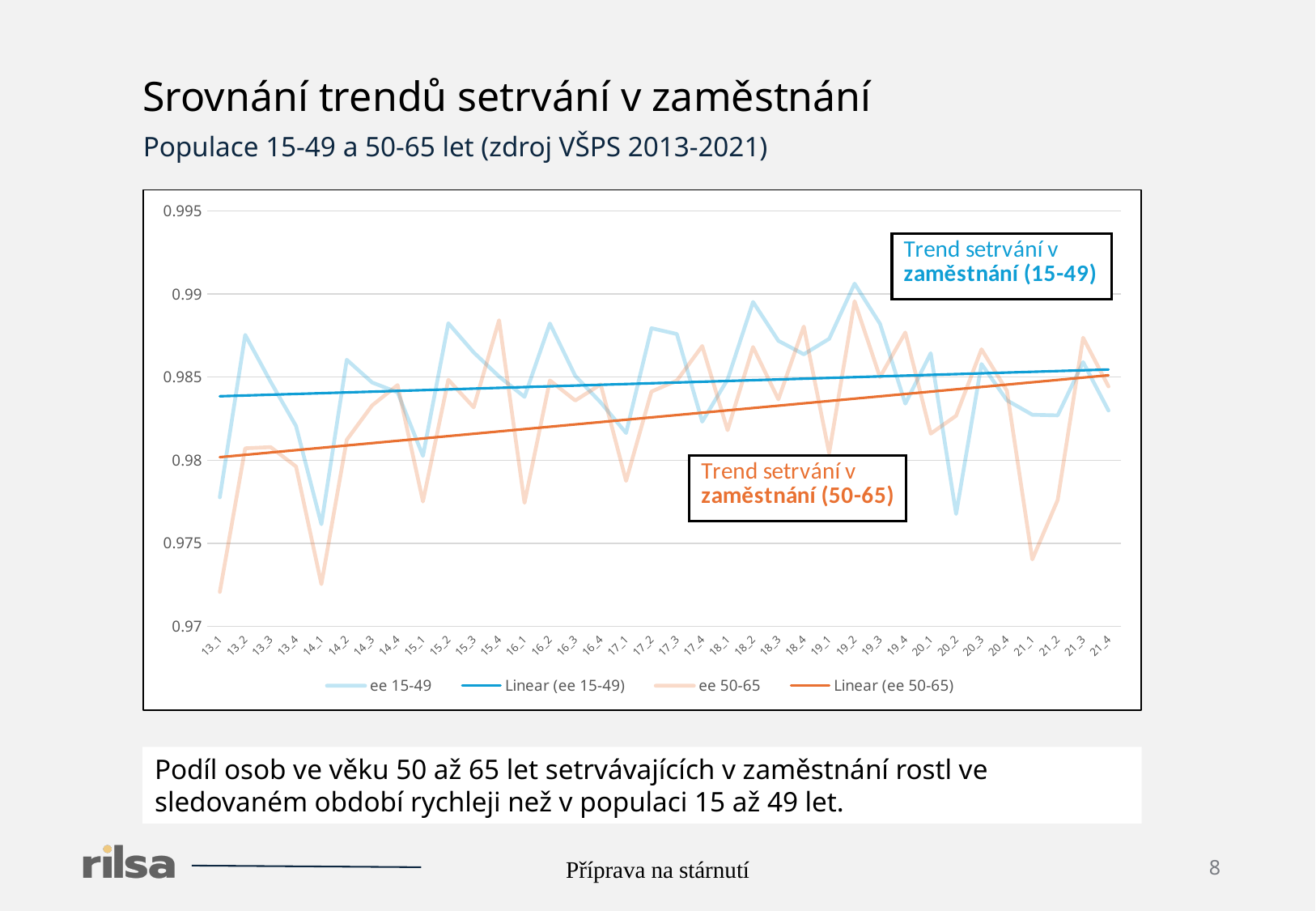
Is the value of ee 15-49 at 19_2 greater or less than 0.99? greater Does the Linear (ee 15-49) trend line rise or fall from left to right? rises Which trend line rises more steeply, Linear (ee 15-49) or Linear (ee 50-65)? Linear (ee 50-65) At 13_1, which trend line is higher, Linear (ee 15-49) or Linear (ee 50-65)? Linear (ee 15-49) What kind of chart is shown on the slide? line chart Does the Linear (ee 50-65) trend line rise or fall from left to right? rises Is the value of ee 50-65 at 13_1 greater or less than 0.975? less How many series does the chart legend list? 4 How many quarterly points are plotted along the x axis (from 13_1 to 21_4)? 36 What is the title of the slide containing the chart? Srovnání trendů setrvání v zaměstnání At 13_1, which series has the higher value, ee 15-49 or ee 50-65? ee 15-49 Is the value of ee 15-49 at 20_2 greater or less than 0.98? less